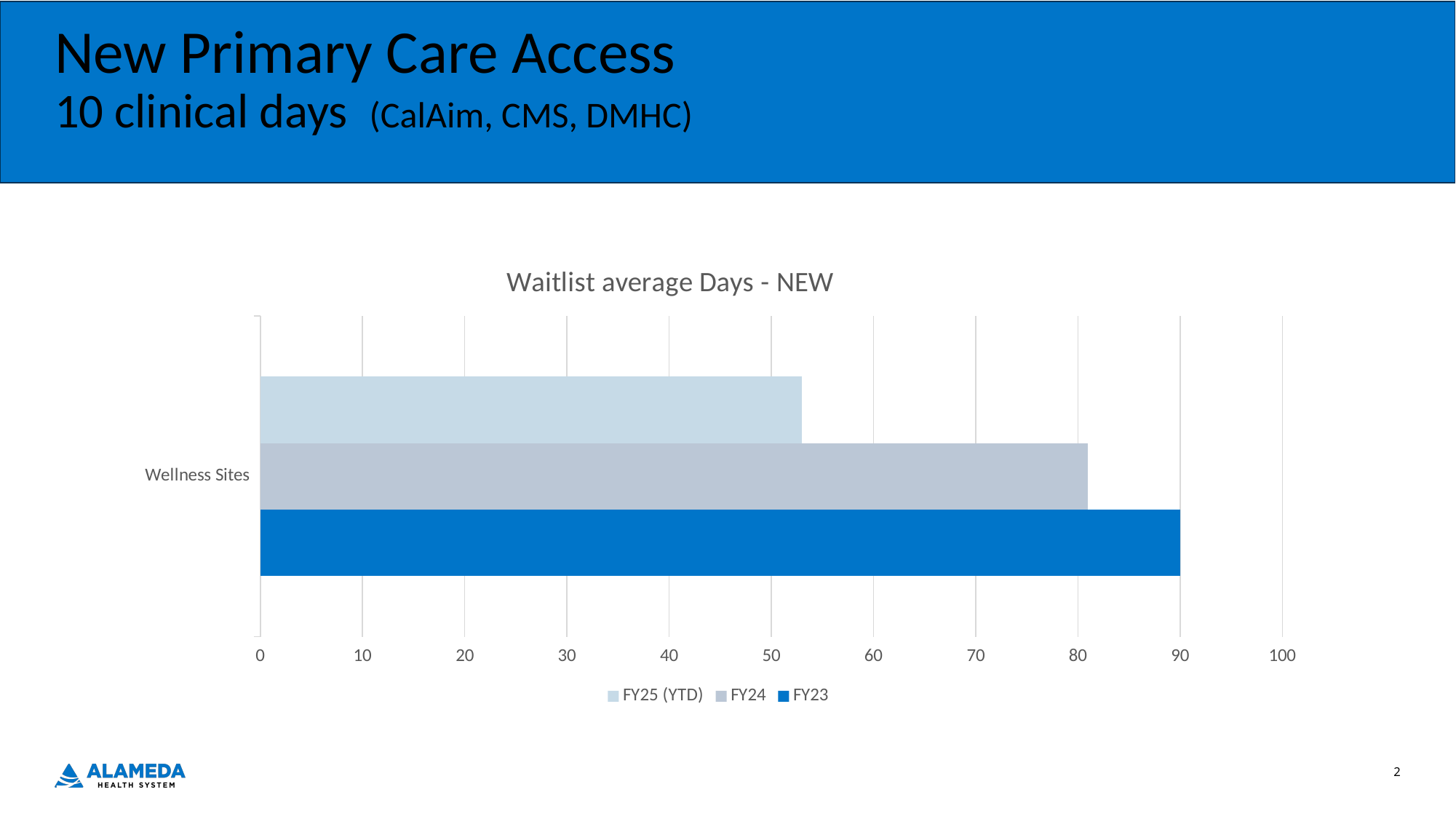
Which series is shown in the darkest blue colour? FY23 How many series does the legend list? 3 Do the waitlist average days for Wellness Sites rise or fall from FY23 to FY25 (YTD)? fall Is the value for FY25 (YTD) greater or less than 60? less How many categories are shown on the vertical axis of the chart? 1 What is the waitlist average days value for FY23 at Wellness Sites? 90 Which series has the highest waitlist average days for Wellness Sites? FY23 Which is larger for Wellness Sites, the FY24 value or the FY25 (YTD) value? FY24 Which series has the lowest waitlist average days for Wellness Sites? FY25 (YTD) What type of chart is shown on the slide? Bar chart Is the value for FY24 greater or less than 70? greater What is the title of the chart? Waitlist average Days - NEW